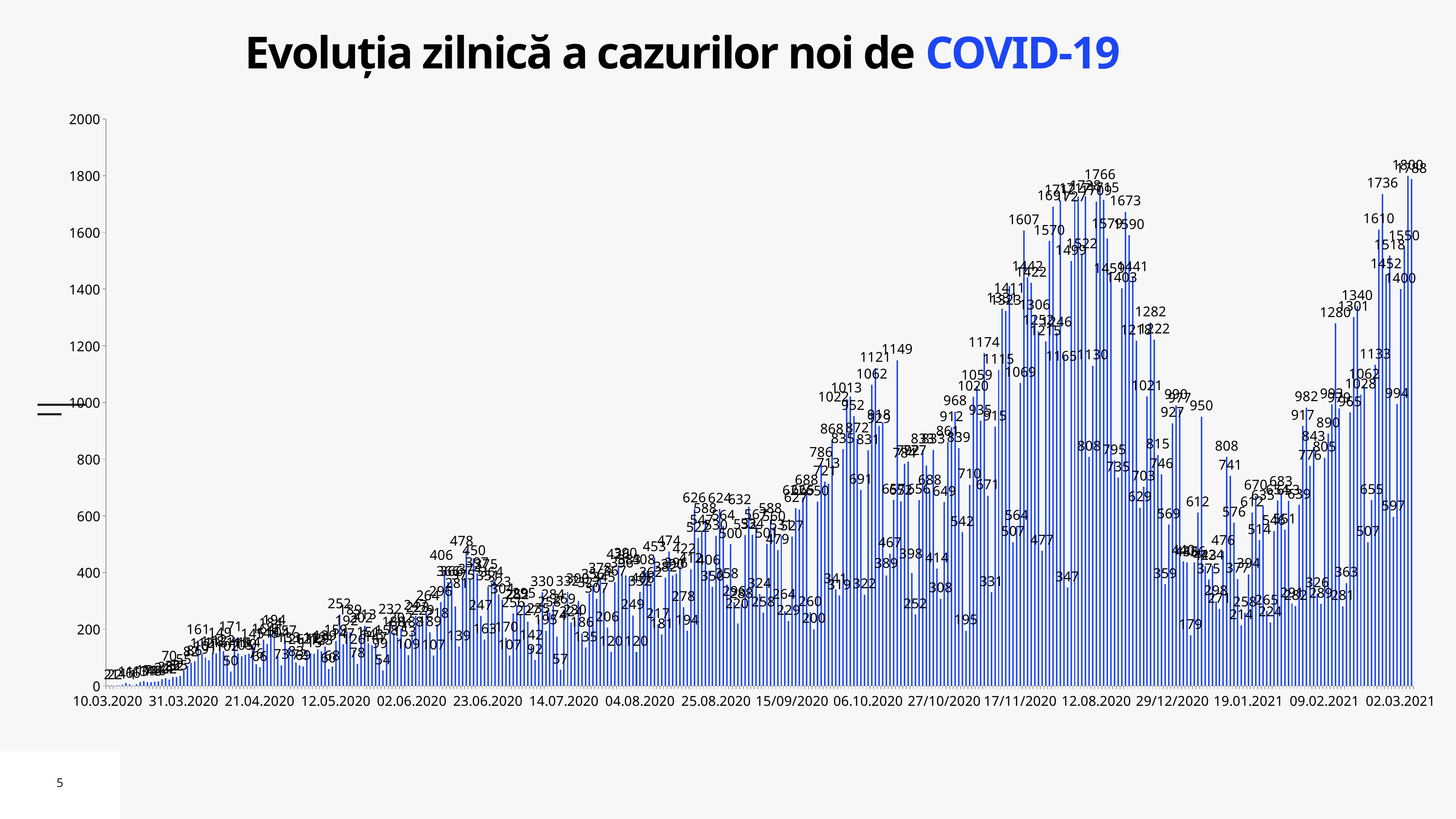
What is the title of the chart? Evoluția zilnică a cazurilor noi de COVID-19 What is the value of the lowest bar near the 14.07.2020 tick? 57 Is the value of the first bar, at 10.03.2020, greater or less than 200? less What is the value of the tallest bar in the June 2020 peak, near the 23.06.2020 tick? 478 Is the value of the last bar, at 02.03.2021, greater or less than 1600? greater What is the value of the tallest bar in the peak just before the 12.08.2020 tick? 1766 What is the highest value shown on the vertical axis? 2000 What is the difference between the bars labelled 1766 and 1607? 159 Which is larger, the bar labelled 1766 or the bar labelled 1607? 1766 What is the difference between the bars labelled 1736 and 1610? 126 Overall, do the daily values rise or fall from 10.03.2020 to 02.03.2021? rise What kind of chart is shown on the slide? bar chart